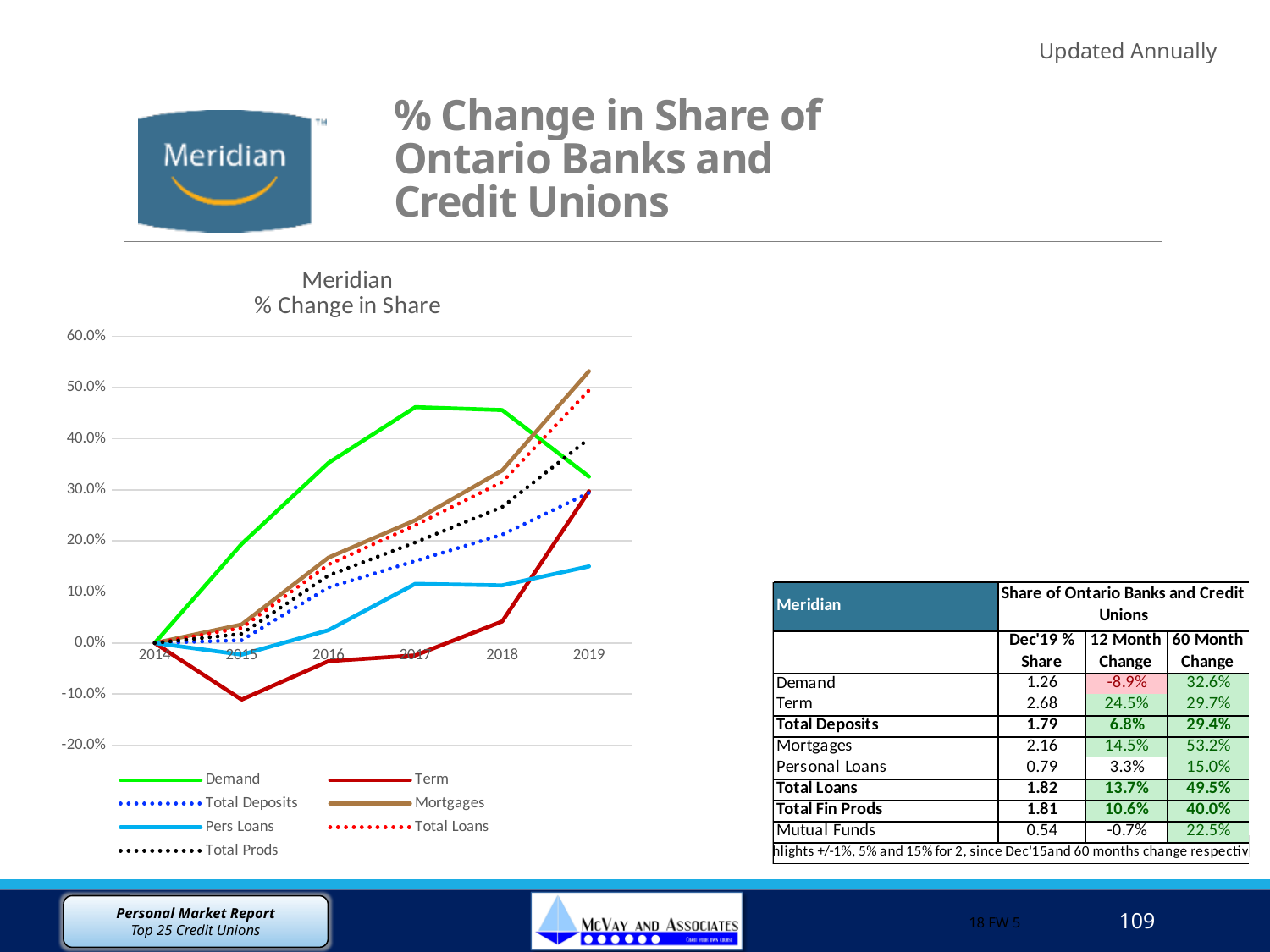
How many series does the legend of the "Meridian % Change in Share" chart list? 7 In the "Meridian % Change in Share" chart, which series has the lowest value in 2015? Term How many years are shown on the x axis of the "Meridian % Change in Share" chart? 6 In the "Meridian % Change in Share" chart, does the Demand line rise or fall from 2018 to 2019? fall In the "Meridian % Change in Share" chart, is the value for Mortgages in 2019 greater or less than 50.0%? greater In the "Meridian % Change in Share" chart, is the value for Demand in 2017 greater or less than 40.0%? greater In the "Meridian % Change in Share" chart, what colour is the Demand line? green In the "Meridian % Change in Share" chart, which series has the highest value in 2018? Demand What kind of chart is the "Meridian % Change in Share" chart? line chart In the "Meridian % Change in Share" chart, is the value for Pers Loans in 2019 greater or less than 20.0%? less In the "Meridian % Change in Share" chart, which is larger in 2017, Demand or Term? Demand